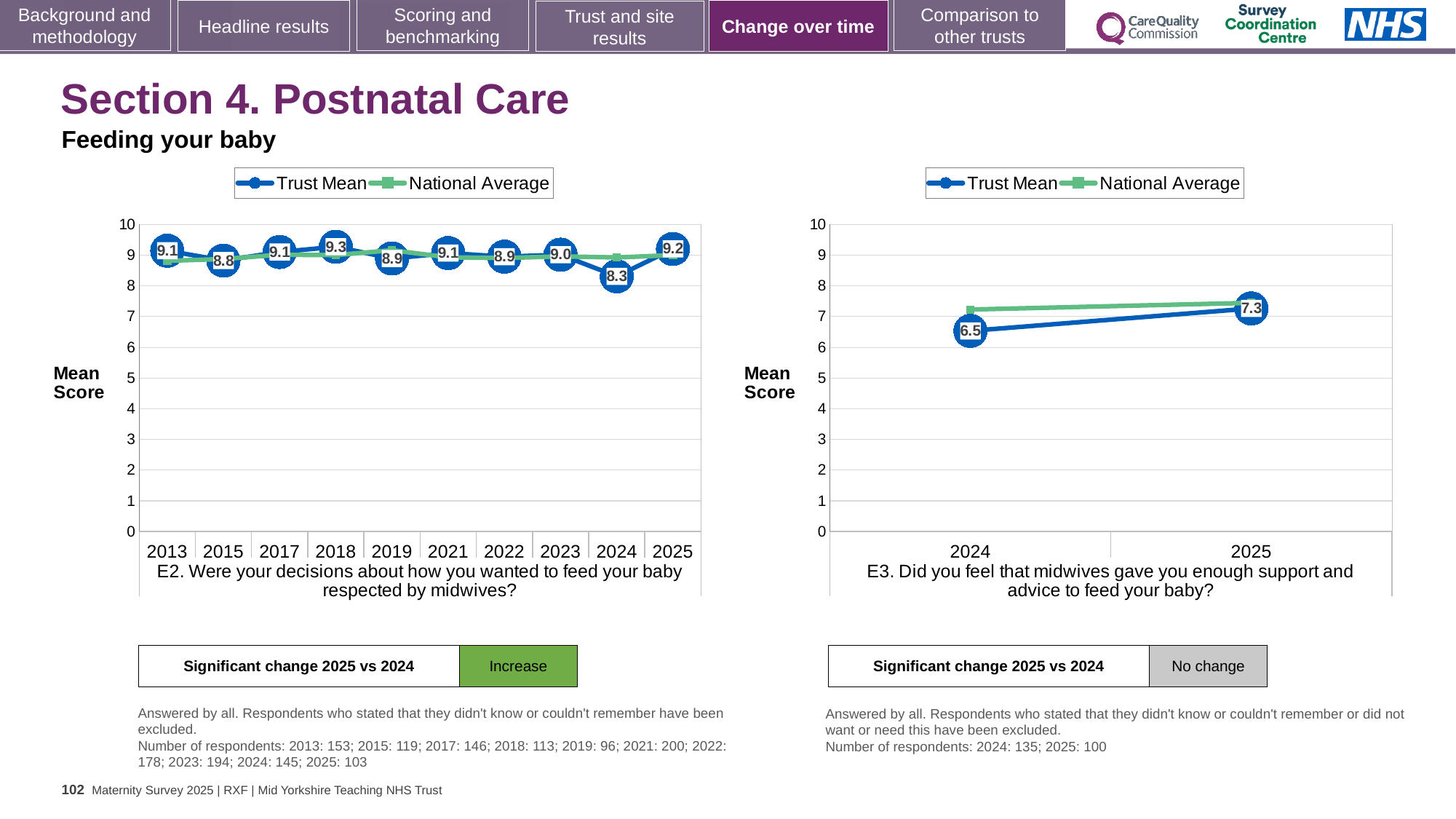
In the E3 chart on the right, does the Trust Mean score rise or fall from 2024 to 2025? rise How many series does the legend of the E3 chart on the right list? 2 In the E2 chart on the left, by how much did the Trust Mean score change from 2024 to 2025? 0.9 In the E2 chart on the left, which year has the highest Trust Mean score? 2018 In the E3 chart on the right, is the National Average value for 2024 greater or less than 8? less In the E2 chart on the left, what is the Trust Mean score for 2024? 8.3 In the E3 chart on the right, what is the difference between the Trust Mean scores for 2025 and 2024? 0.8 In the E2 chart on the left, which year has the lowest Trust Mean score? 2024 In the E3 chart on the right, what is the Trust Mean score for 2025? 7.3 In the E2 chart on the left, what is the Trust Mean score for 2018? 9.3 How many years are plotted on the x axis of the E2 chart on the left? 10 In the E2 chart on the left, is the Trust Mean score higher in 2015 or in 2017? 2017